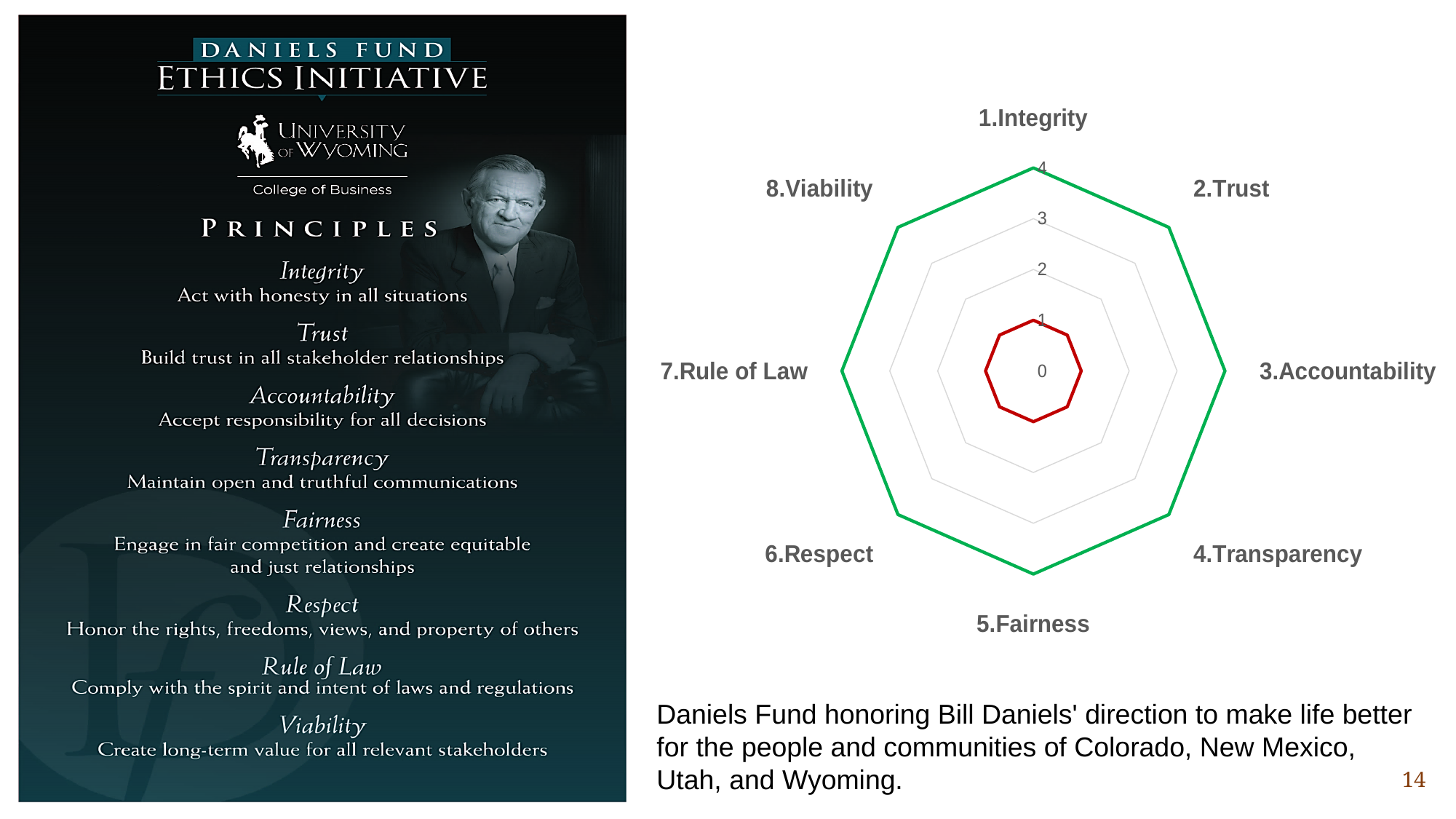
Is the value of the red series for 8.Viability greater or less than 2 on the radar chart? less Which category label appears at the top of the radar chart? 1.Integrity What is the value of the green series for 1.Integrity on the radar chart? 4 How many categories (axes) does the radar chart have? 8 Is the value of the green series for 6.Respect greater or less than 2 on the radar chart? greater What is the value of the green series for 5.Fairness on the radar chart? 4 What kind of chart is shown on the right side of the slide? radar chart On the radar chart, which series has the larger value for 2.Trust, the green or the red? green What is the value of the red series for 3.Accountability on the radar chart? 1 What is the difference between the green and red series values for 4.Transparency on the radar chart? 3 What is the value of the red series for 7.Rule of Law on the radar chart? 1 What is the maximum value shown on the radar chart's axis scale? 4